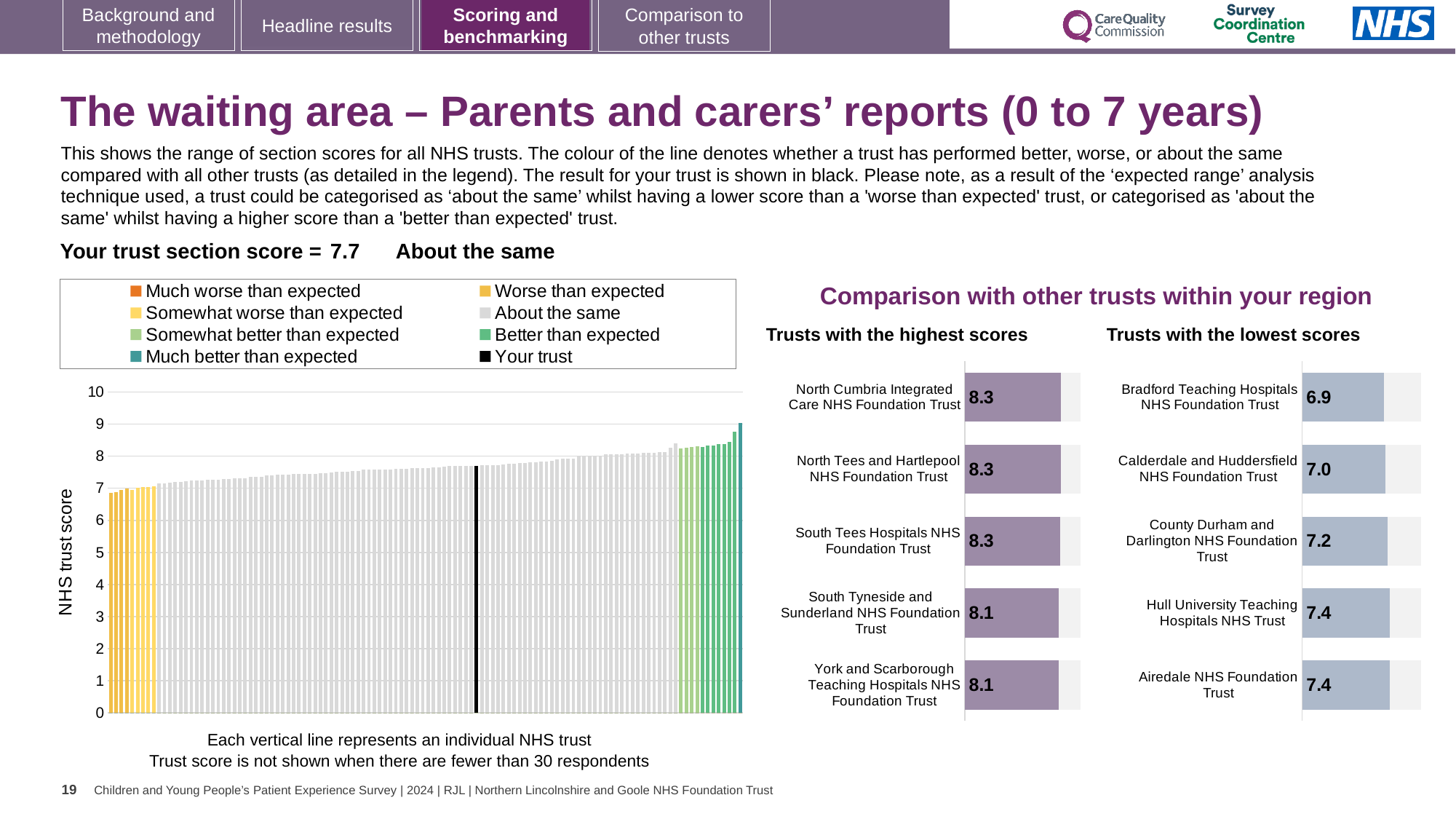
On the main chart on the left, what is the section score for your trust (the black bar)? 7.7 How many trusts are shown on the 'Trusts with the highest scores' chart? 5 On the 'Trusts with the lowest scores' chart, what is the score for County Durham and Darlington NHS Foundation Trust? 7.2 On the 'Trusts with the lowest scores' chart, which has the higher score: Calderdale and Huddersfield NHS Foundation Trust or County Durham and Darlington NHS Foundation Trust? County Durham and Darlington NHS Foundation Trust How many entries does the legend of the main chart on the left list? 8 On the main chart on the left, is the value of the tallest bar greater or less than 8? greater On the 'Trusts with the highest scores' chart, what is the score for South Tyneside and Sunderland NHS Foundation Trust? 8.1 On the 'Trusts with the lowest scores' chart, which trust has the lowest score? Bradford Teaching Hospitals NHS Foundation Trust On the 'Trusts with the lowest scores' chart, what is the difference between the scores of Hull University Teaching Hospitals NHS Trust and Bradford Teaching Hospitals NHS Foundation Trust? 0.5 On the 'Trusts with the highest scores' chart, what is the difference between the scores of North Cumbria Integrated Care NHS Foundation Trust and York and Scarborough Teaching Hospitals NHS Foundation Trust? 0.2 What kind of chart is the main chart on the left showing the range of section scores? Bar chart On the 'Trusts with the highest scores' chart, what is the score for North Cumbria Integrated Care NHS Foundation Trust? 8.3